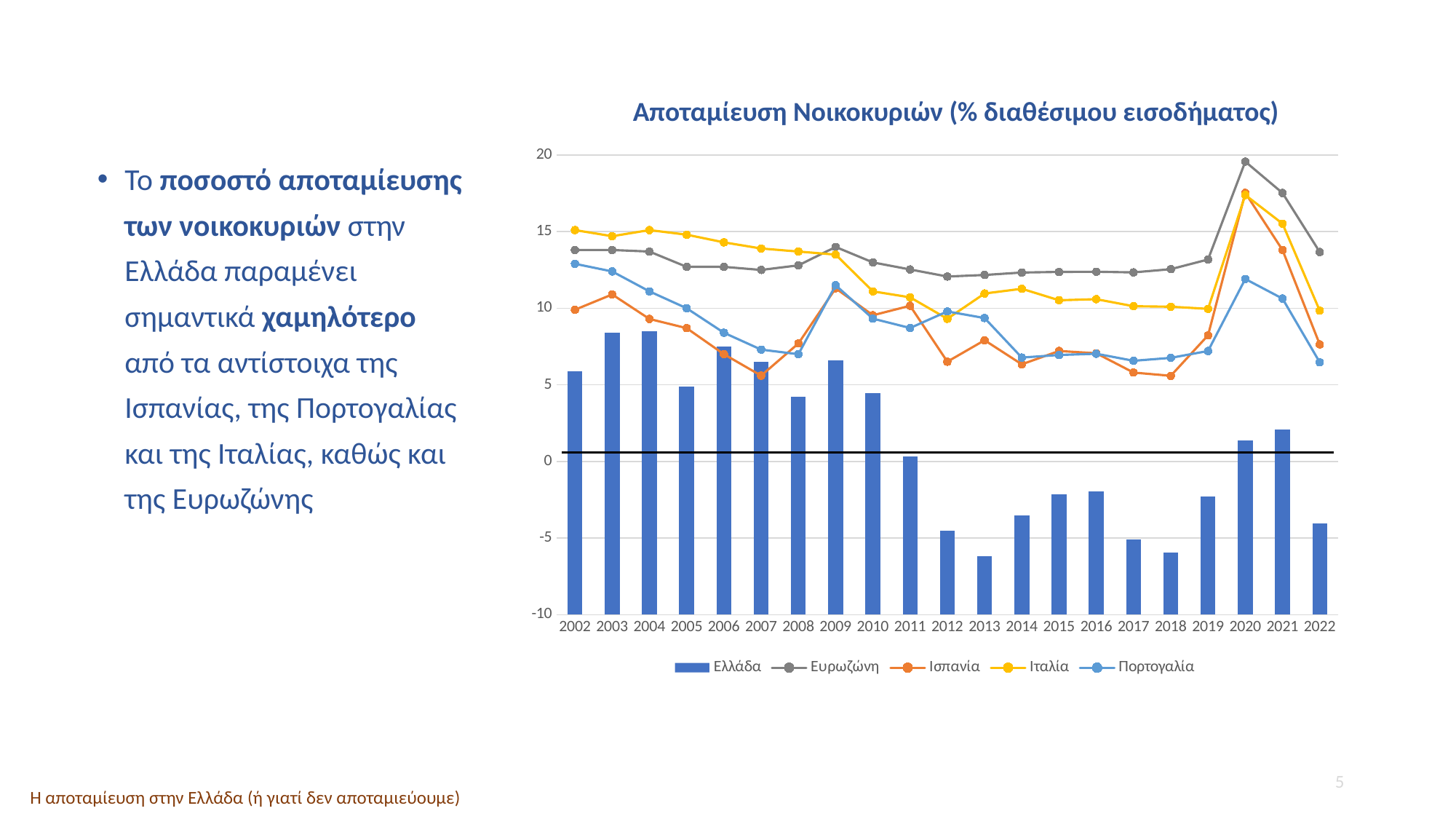
What is the title of the chart? Αποταμίευση Νοικοκυριών (% διαθέσιμου εισοδήματος) What kind of chart is shown on the slide? A combined bar and line chart In 2020, which is higher: Ευρωζώνη or Ιταλία? Ευρωζώνη In 2002, which is higher: Ιταλία or Ισπανία? Ιταλία Is the value for Πορτογαλία in 2022 greater or less than 10? less Is the value for Ελλάδα in 2012 greater or less than 0? less How many series does the legend list? 5 Which series is plotted as bars rather than a line? Ελλάδα How many years are shown on the x axis? 21 Is the value for Ευρωζώνη in 2020 greater or less than 15? greater Do the values for Ελλάδα rise or fall from 2009 to 2013? fall In which year does the Ευρωζώνη series reach its highest value? 2020